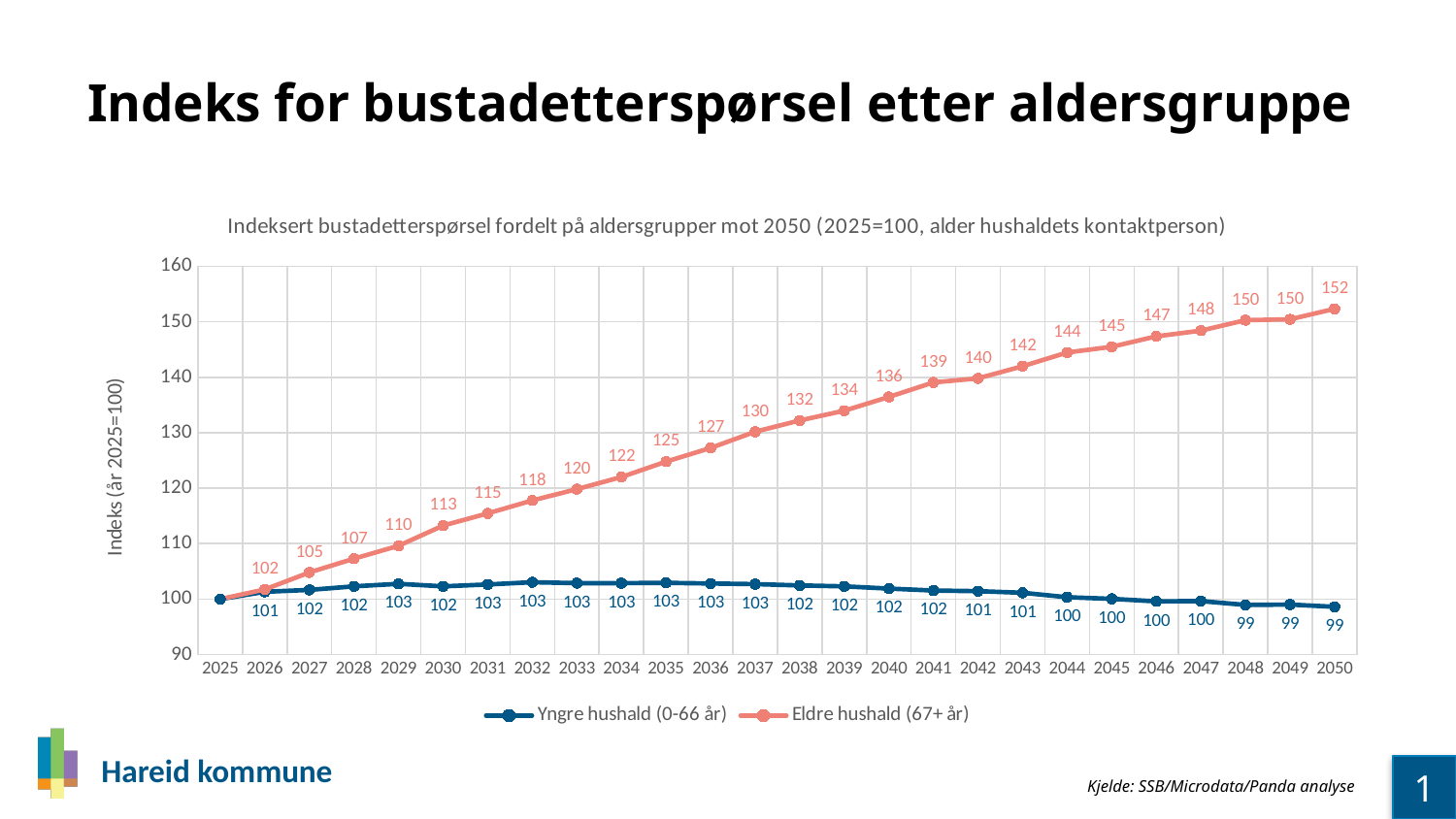
In which year does Eldre hushald (67+ år) reach its highest value? 2050 What is the value for Eldre hushald (67+ år) in 2040? 136 What is the difference between Eldre hushald (67+ år) and Yngre hushald (0-66 år) in 2050? 53 Which series has the higher value in 2045, Yngre hushald (0-66 år) or Eldre hushald (67+ år)? Eldre hushald (67+ år) How many series does the legend list? 2 Does the Eldre hushald (67+ år) series rise or fall from 2025 to 2050? Rise Is the value for Eldre hushald (67+ år) in 2025 greater or less than 110? less What kind of chart is shown on the slide? Line chart What is the value for Eldre hushald (67+ år) in 2050? 152 What is the difference between the Eldre hushald (67+ år) values in 2050 and 2026? 50 What is the value for Yngre hushald (0-66 år) in 2035? 103 What is the value for Yngre hushald (0-66 år) in 2050? 99